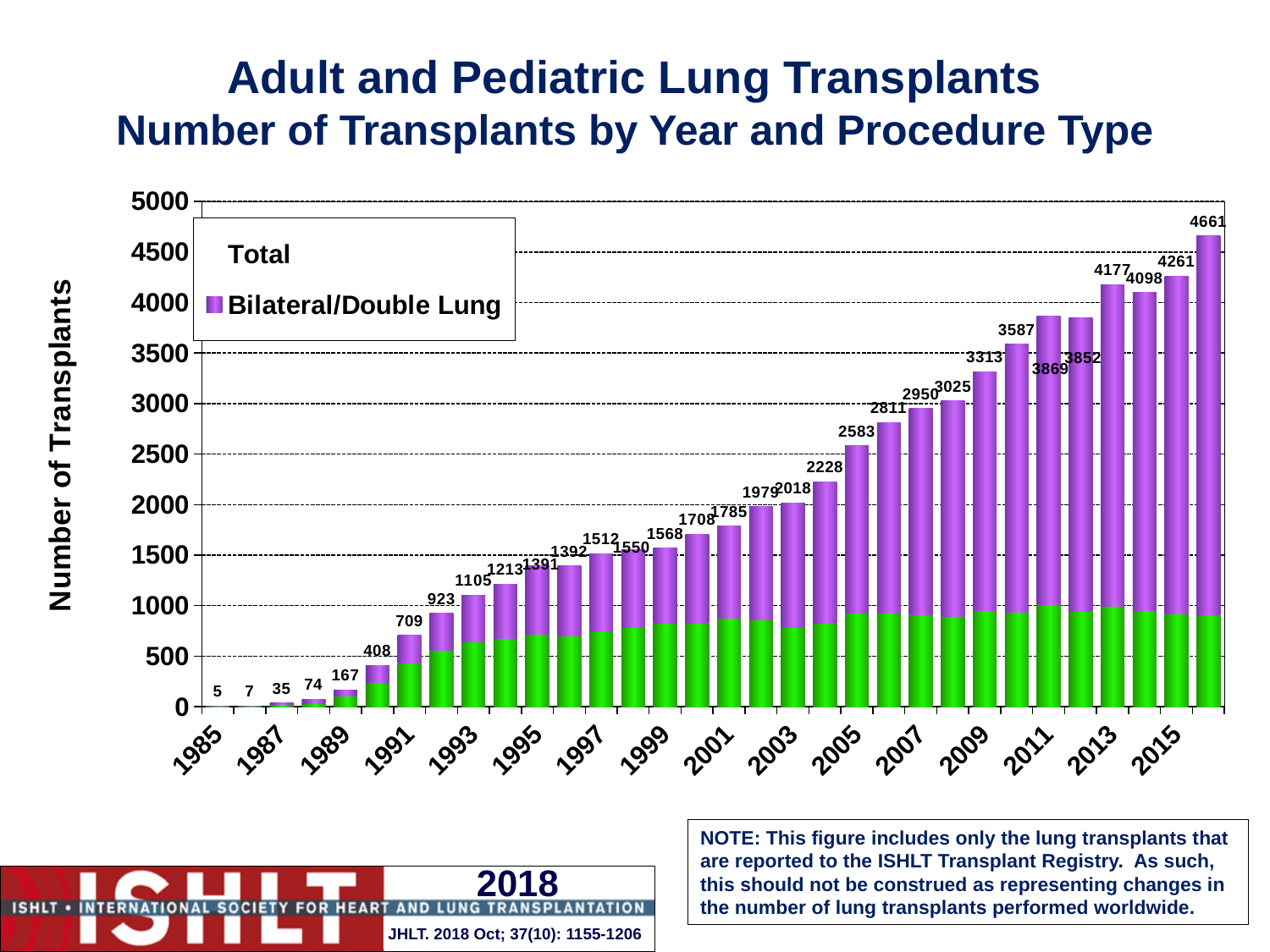
Do the total transplant numbers generally rise or fall from 1985 to 2016? Rise Which year has a larger total, 2011 or 2012? 2011 Is the Bilateral/Double Lung portion of the 2016 bar greater or less than 3000? greater What colour represents Bilateral/Double Lung in the legend? Purple Which year has the lowest total number of transplants? 1985 What type of chart is shown on the slide? Stacked bar chart What is the difference between the total transplants in 2016 and 2015? 400 Which year has the highest total number of transplants? 2016 What is the total number of lung transplants shown for 2005? 2583 What is the total number of lung transplants shown for 1990? 408 What is the total number of lung transplants shown for 2016? 4661 How many years (bars) are plotted on the chart? 32